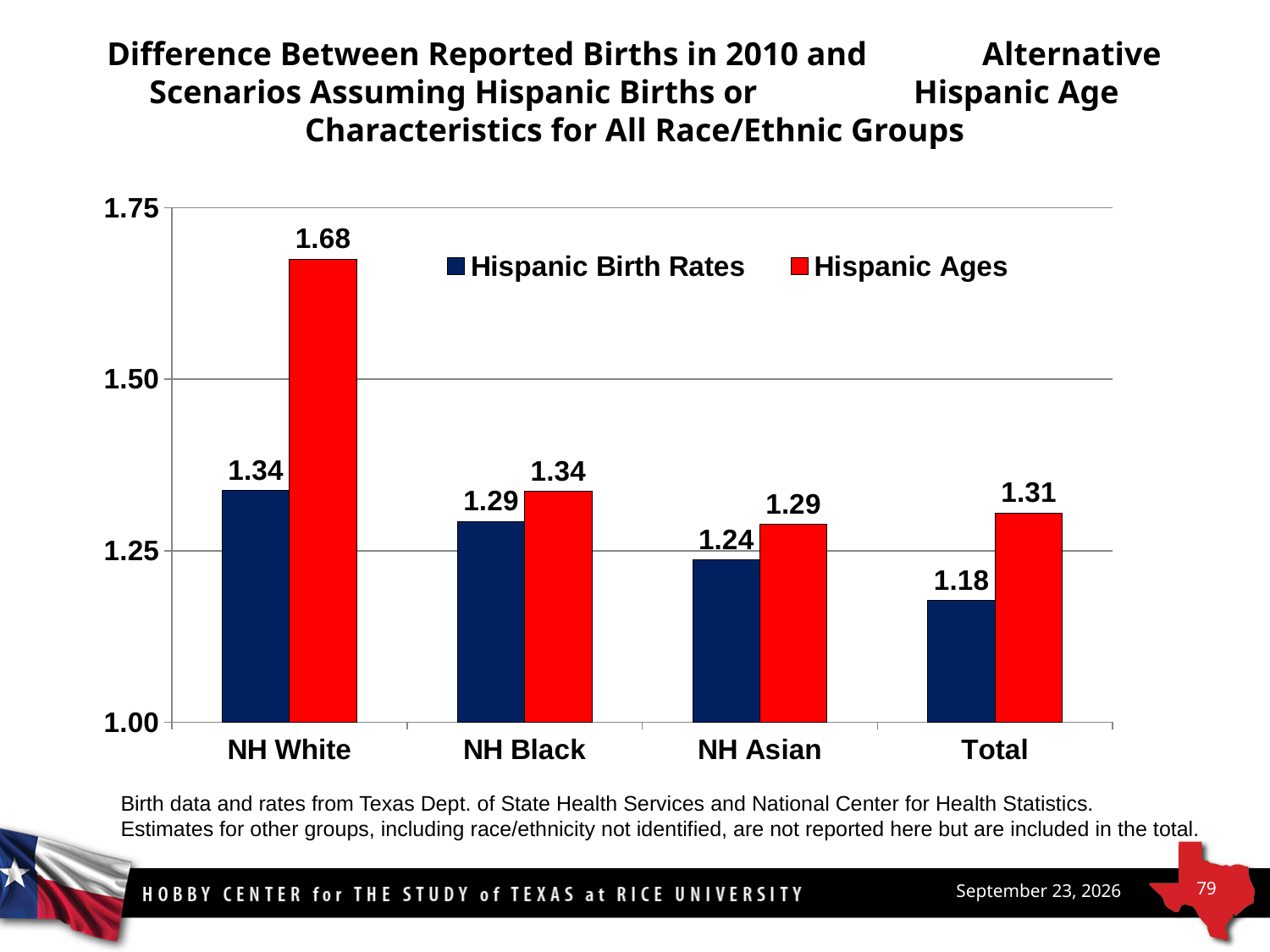
Which category has the highest Hispanic Ages value? NH White Which is larger for NH Black: the Hispanic Birth Rates value or the Hispanic Ages value? Hispanic Ages What is the Hispanic Birth Rates value for NH Asian? 1.24 What kind of chart is shown on the slide? bar chart What is the Hispanic Birth Rates value for Total? 1.18 How many series does the legend list? 2 What is the difference between the Hispanic Ages and Hispanic Birth Rates values for NH White? 0.34 How many categories are shown on the x axis? 4 Is the Hispanic Ages value for NH White greater or less than 1.50? greater What is the difference between the Hispanic Ages and Hispanic Birth Rates values for Total? 0.13 Which category has the lowest Hispanic Birth Rates value? Total What is the Hispanic Ages value for NH White? 1.68